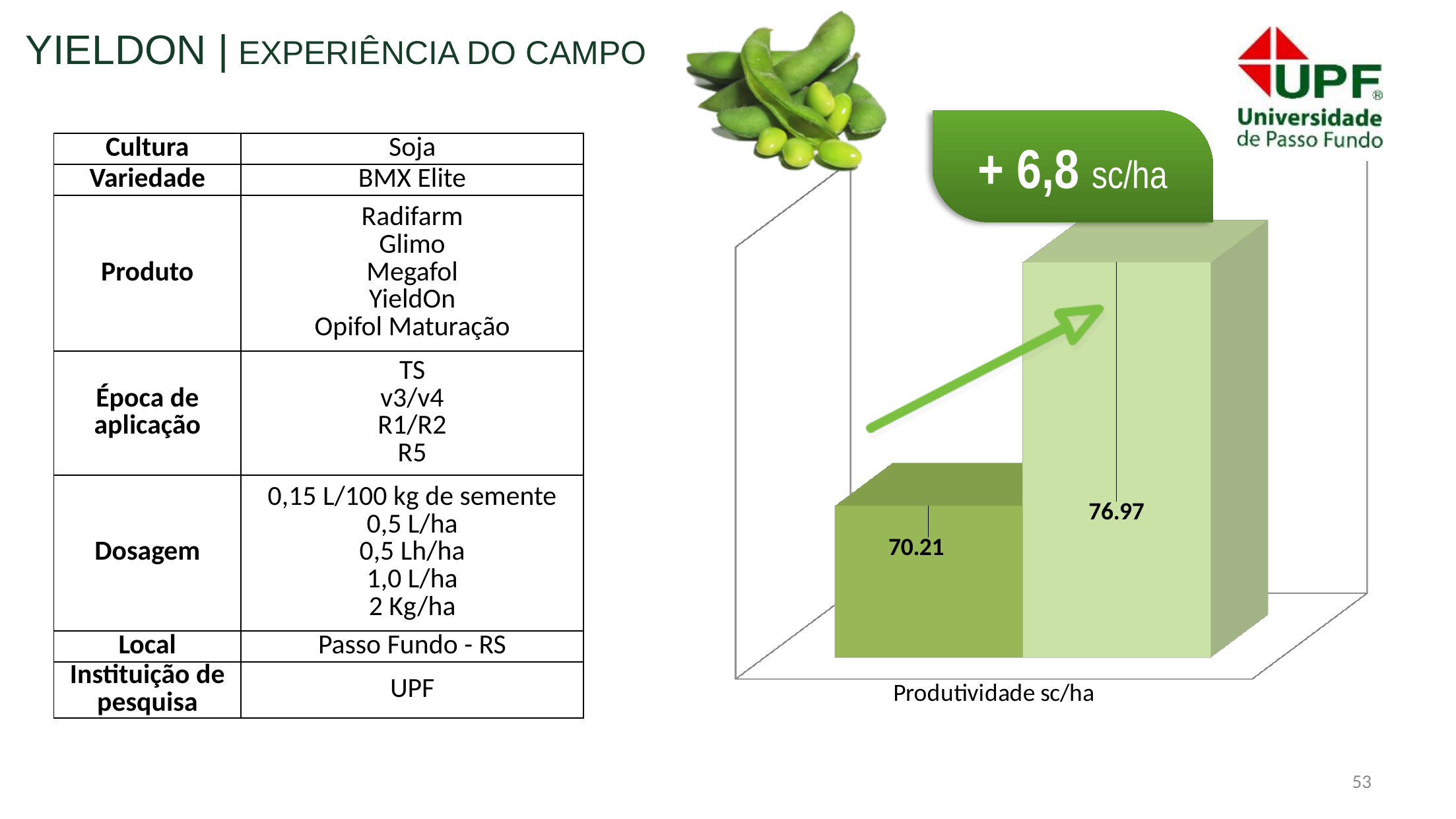
Do the bar values rise or fall from left to right in the chart? rise Is the value of the right bar larger or smaller than the value of the left bar? larger What value is printed on the right (lighter green) bar of the chart? 76.97 What is the axis label printed below the bars of the chart? Produtividade sc/ha What is the difference between the two bar values shown in the chart (76.97 and 70.21)? 6.76 How many bars are plotted in the chart? 2 What value is printed on the left (darker green) bar of the chart? 70.21 What kind of chart is shown on the right side of the slide? bar chart What gain is stated in the green callout above the chart? + 6,8 sc/ha Which bar in the chart has the higher value, the left or the right one? the right bar Which bar in the chart has the lower value, the left or the right one? the left bar